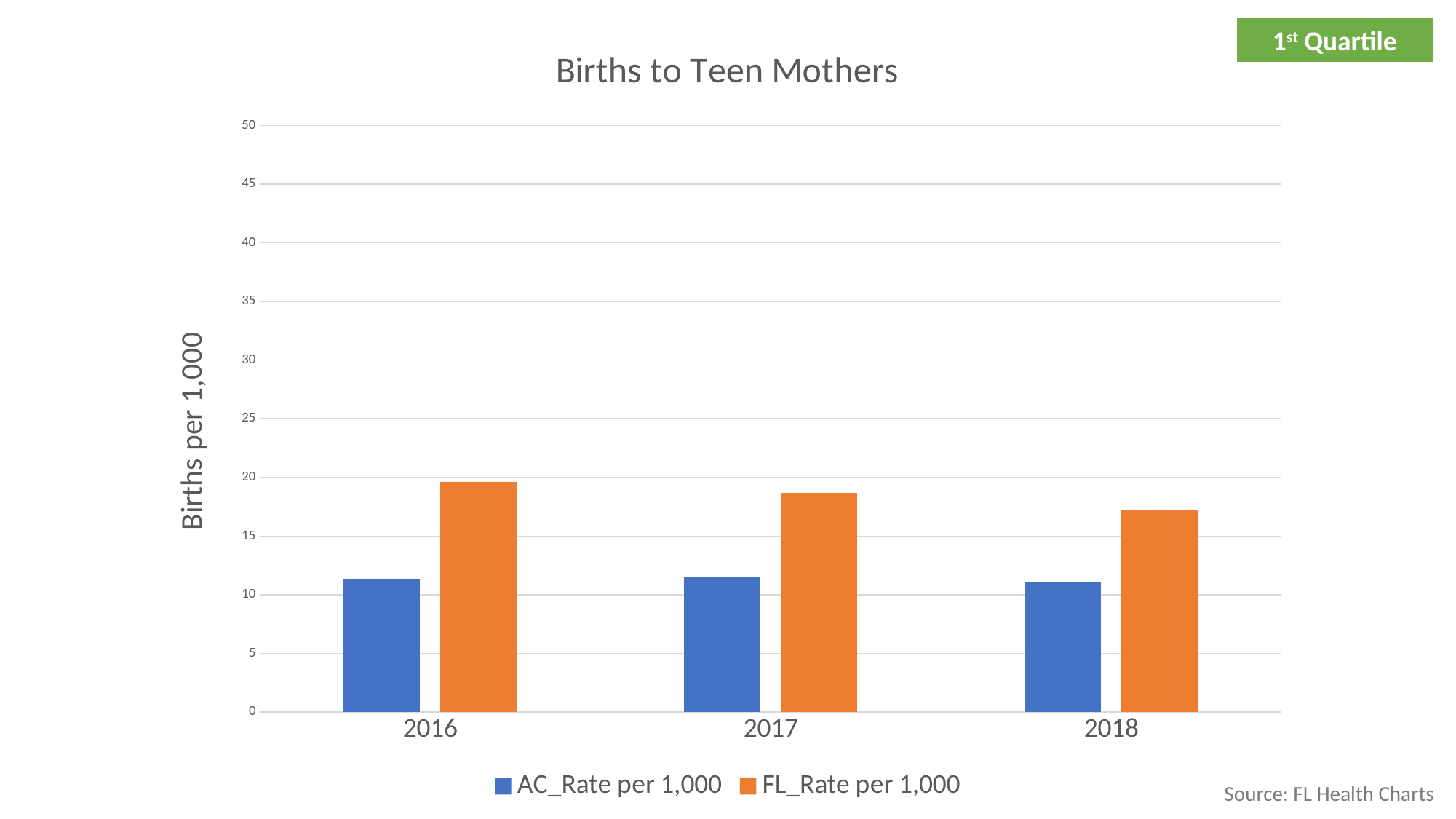
Which year has the lowest FL_Rate per 1,000? 2018 What is the label on the vertical axis? Births per 1,000 What is the title of the chart? Births to Teen Mothers Does the FL_Rate per 1,000 rise or fall from 2016 to 2018? fall Is the AC_Rate per 1,000 for 2018 greater or less than 10? greater Is the FL_Rate per 1,000 for 2016 greater or less than 15? greater How many years are shown on the x axis? 3 How many series does the legend list? 2 Which year has the highest FL_Rate per 1,000? 2016 Is the FL_Rate per 1,000 for 2018 greater or less than 20? less In 2017, which is larger, AC_Rate per 1,000 or FL_Rate per 1,000? FL_Rate per 1,000 What kind of chart is shown on the slide? bar chart